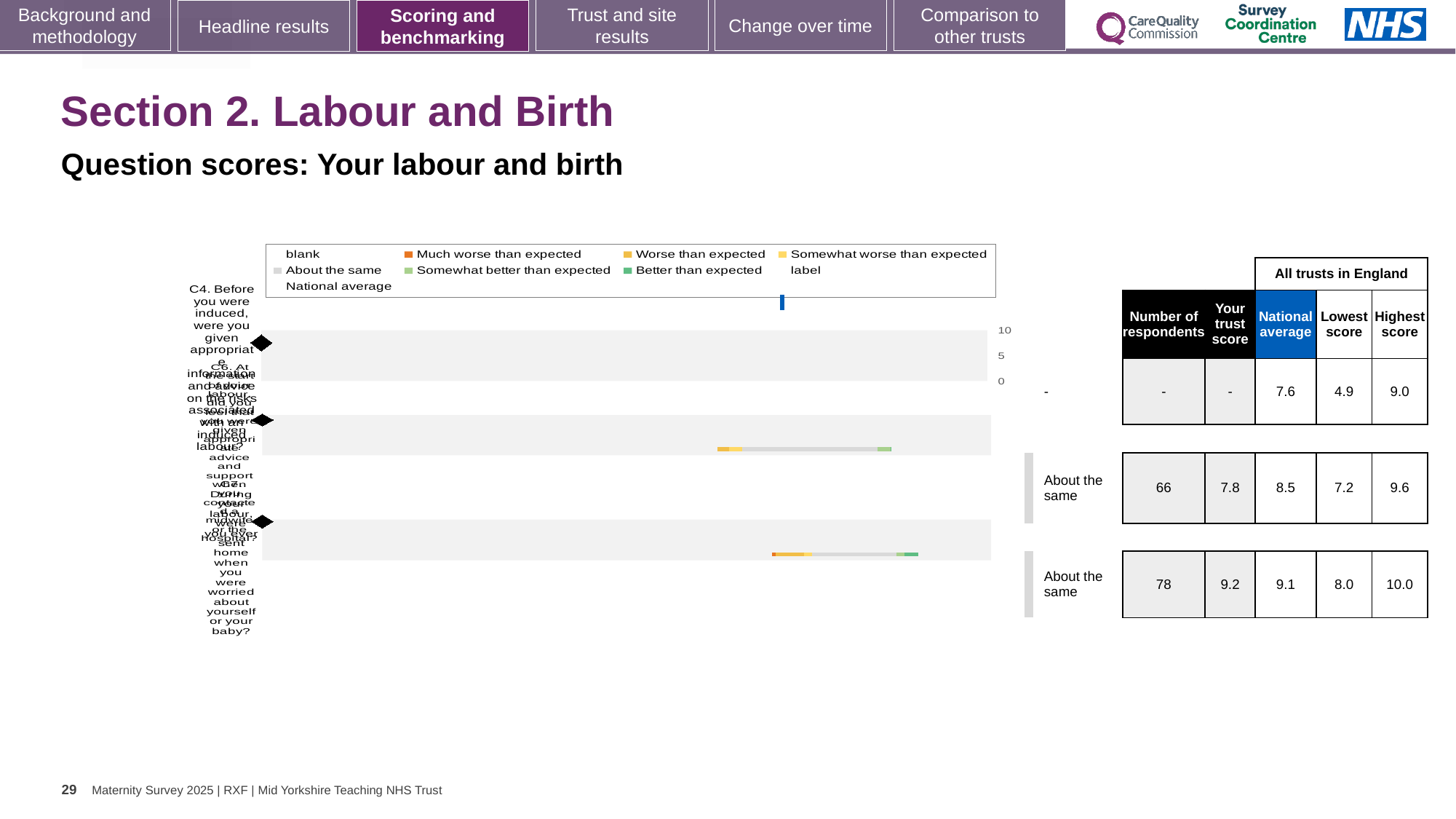
In the table beside the chart, what is the number of respondents for the row whose national average is 9.1? 78 In the table beside the chart, for the row with 78 respondents, is the trust score or the national average larger? trust score (9.2) In the table beside the chart, what is the lowest score for the row whose national average is 7.6? 4.9 In the table beside the chart, what benchmark label is given for the row with 66 respondents? About the same What kind of chart is shown on the slide? bar chart What colour does the legend use for 'Much worse than expected'? orange In the table beside the chart, what is the national average for the row with 66 respondents? 8.5 How many entries does the chart legend list? 9 In the table beside the chart, what is the difference between the highest score and the lowest score for the row with 66 respondents? 2.4 In the table beside the chart, what is the trust score for the row with 78 respondents? 9.2 What is the highest tick value shown on the chart's numeric axis? 10 In the table beside the chart, which row has the highest 'Highest score' value? the row with 78 respondents (10.0)